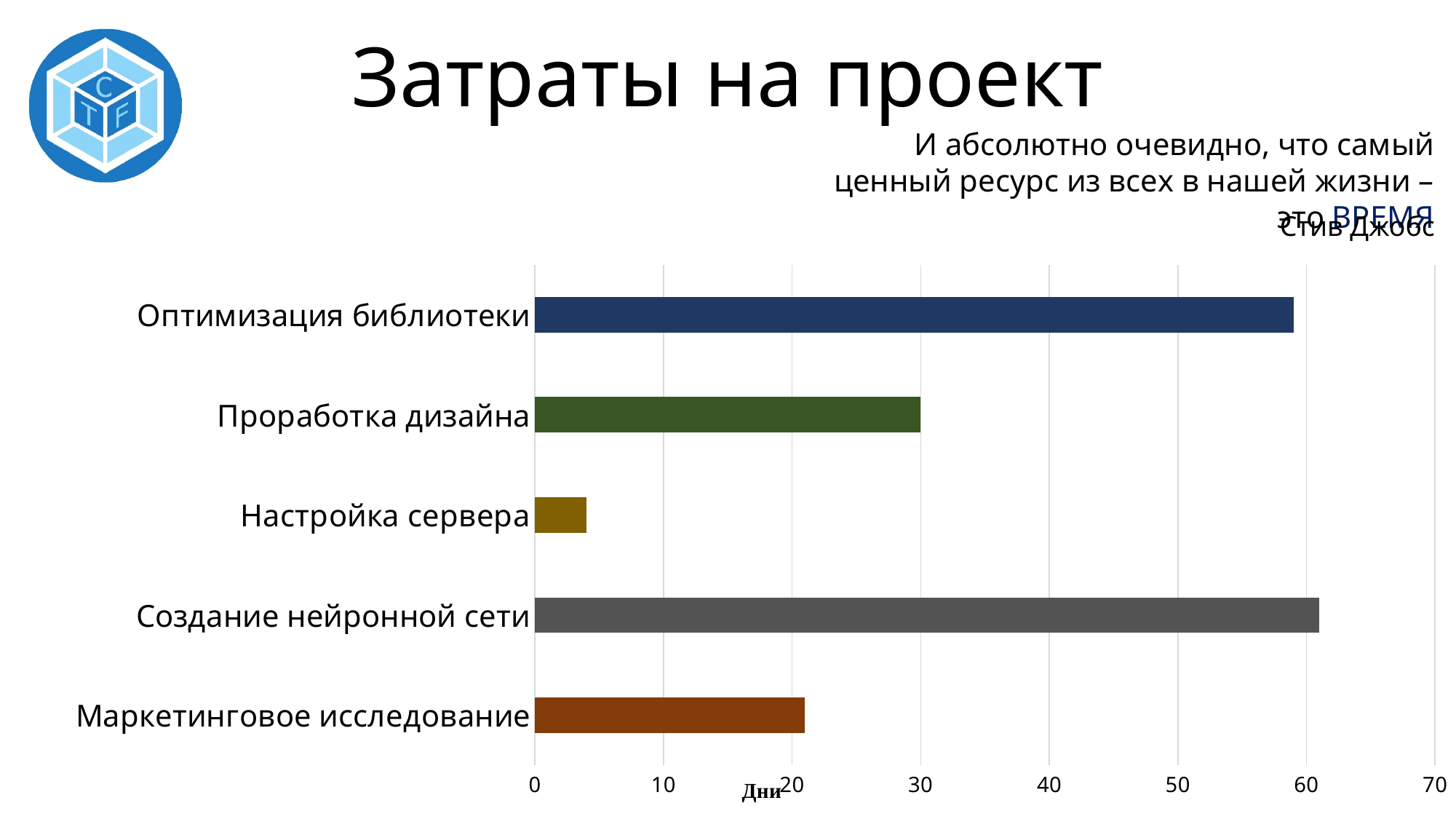
Is the value for Маркетинговое исследование greater or less than 30? less How many categories are plotted in the chart? 5 What kind of chart is shown on the slide? bar chart What is the title of the slide containing the chart? Затраты на проект Is the value for Создание нейронной сети greater or less than 50? greater Is the value for Оптимизация библиотеки greater or less than 50? greater Which category has the longest bar in the chart? Создание нейронной сети What is the label on the horizontal axis of the chart? Дни What is the value for Проработка дизайна? 30 Which category has the shortest bar in the chart? Настройка сервера Which is larger, the value for Проработка дизайна or the value for Маркетинговое исследование? Проработка дизайна